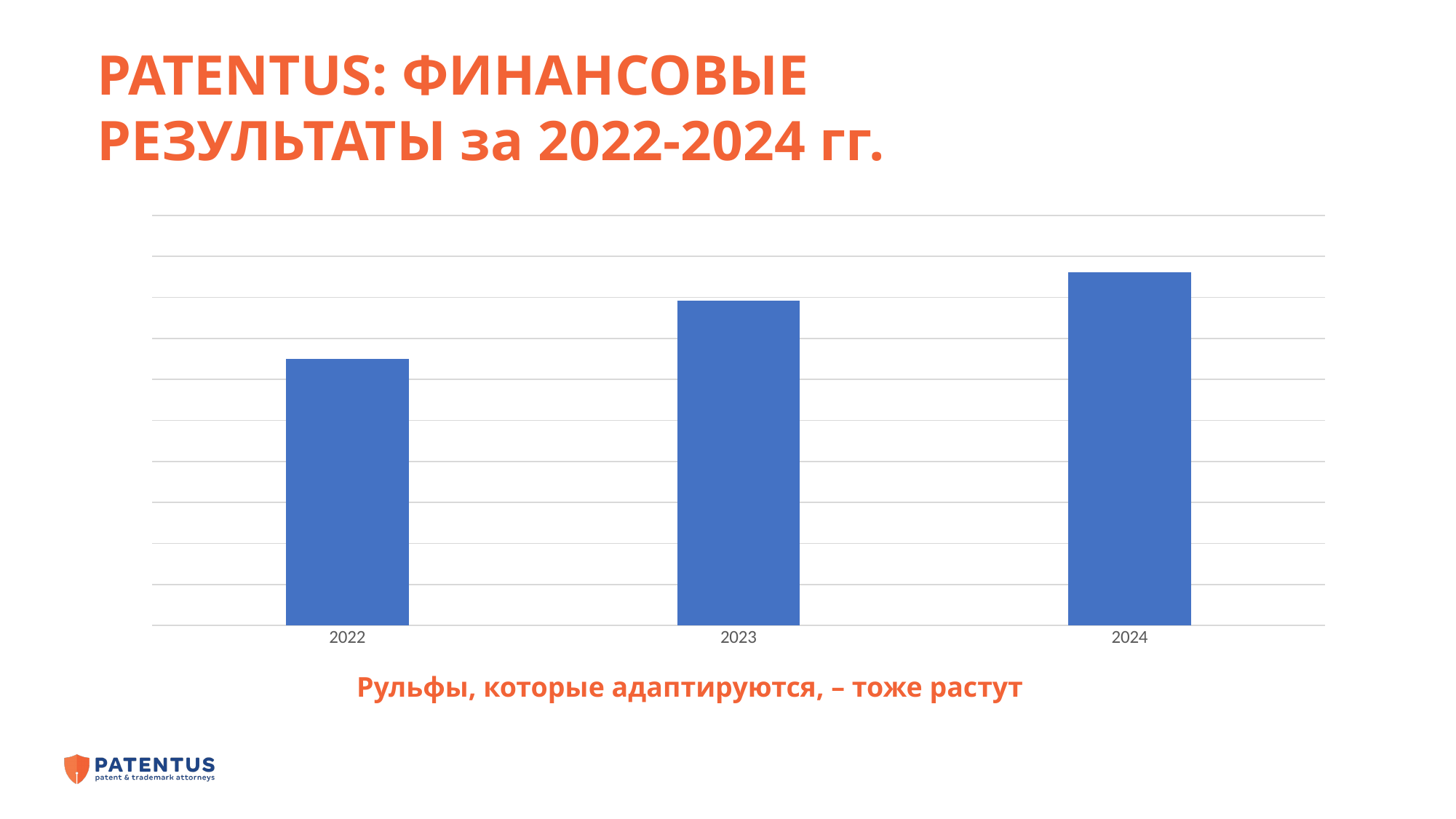
Which year has the highest bar in the chart? 2024 What are the category labels on the x axis of the chart? 2022, 2023, 2024 Which bar is taller, 2023 or 2024? 2024 What colour are the bars in the chart? blue Which bar is taller, 2022 or 2023? 2023 Which year has the lowest bar in the chart? 2022 What kind of chart is shown on the slide? bar chart Do the values rise or fall from 2022 to 2024? rise How many bars (categories) does the chart show? 3